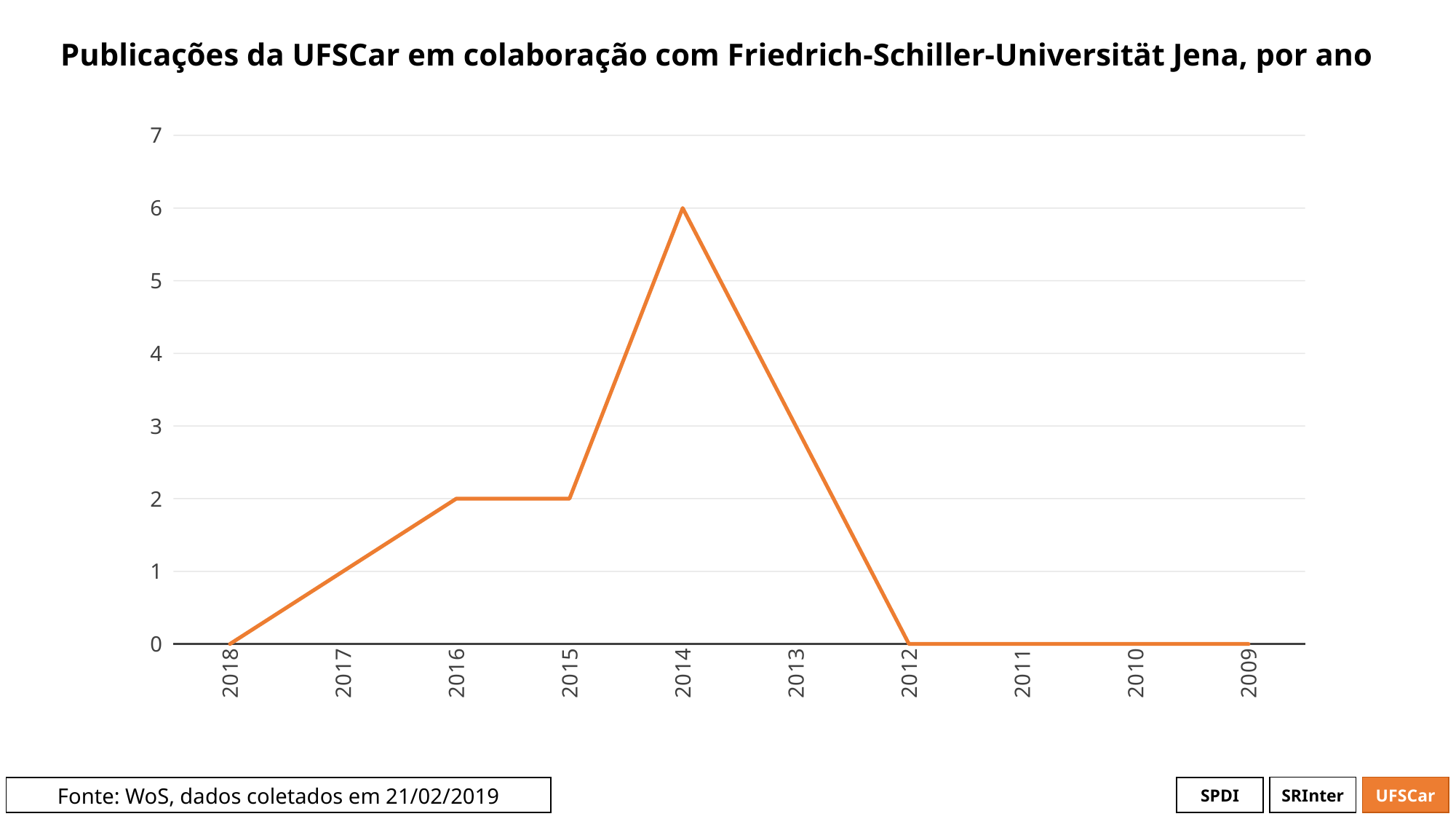
Is the value for 2013 greater or less than 2? greater What is the title of the chart? Publicações da UFSCar em colaboração com Friedrich-Schiller-Universität Jena, por ano Which year has the highest value? 2014 How many years are shown on the x axis? 10 What is the value for 2018? 0 What is the value for 2016? 2 What is the value for 2014? 6 Which is larger, the value for 2014 or the value for 2015? 2014 What is the value for 2010? 0 What is the value for 2015? 2 What is the difference between the values for 2014 and 2016? 4 What kind of chart is shown on the slide? line chart